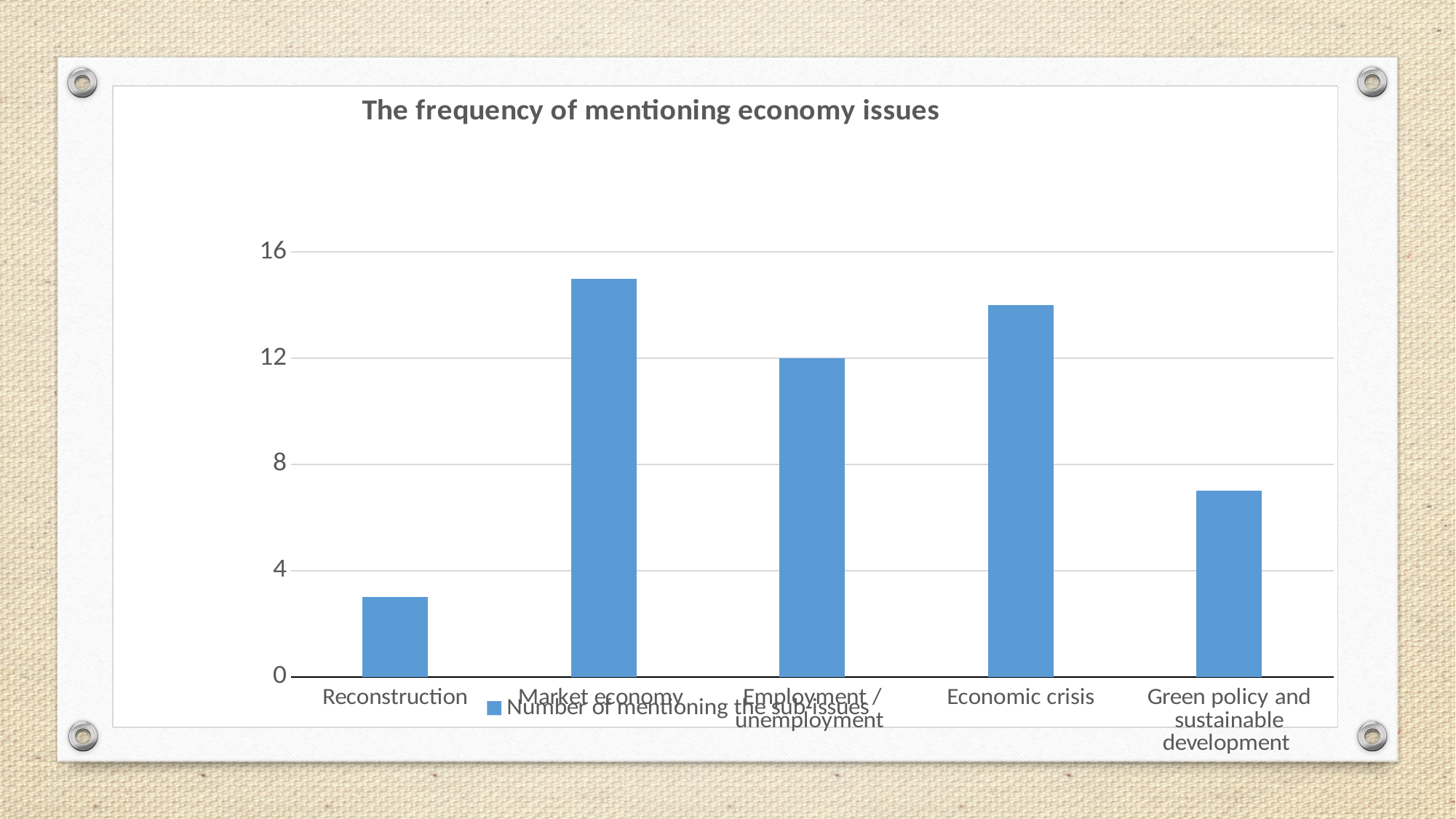
What is the title of the chart? The frequency of mentioning economy issues Is the value for Economic crisis greater or less than 12? greater How many categories are shown on the x axis of the chart? 5 Is the value for Green policy and sustainable development greater or less than 8? less How many series does the chart's legend list? 1 What is the value for Employment / unemployment? 12 What is the legend entry for the series in the chart? Number of mentioning the sub-issues Which is larger, the value for Economic crisis or the value for Green policy and sustainable development? Economic crisis Which category has the lowest value? Reconstruction What type of chart is shown on the slide? Bar chart Is the value for Reconstruction greater or less than 4? less Which category has the highest value? Market economy